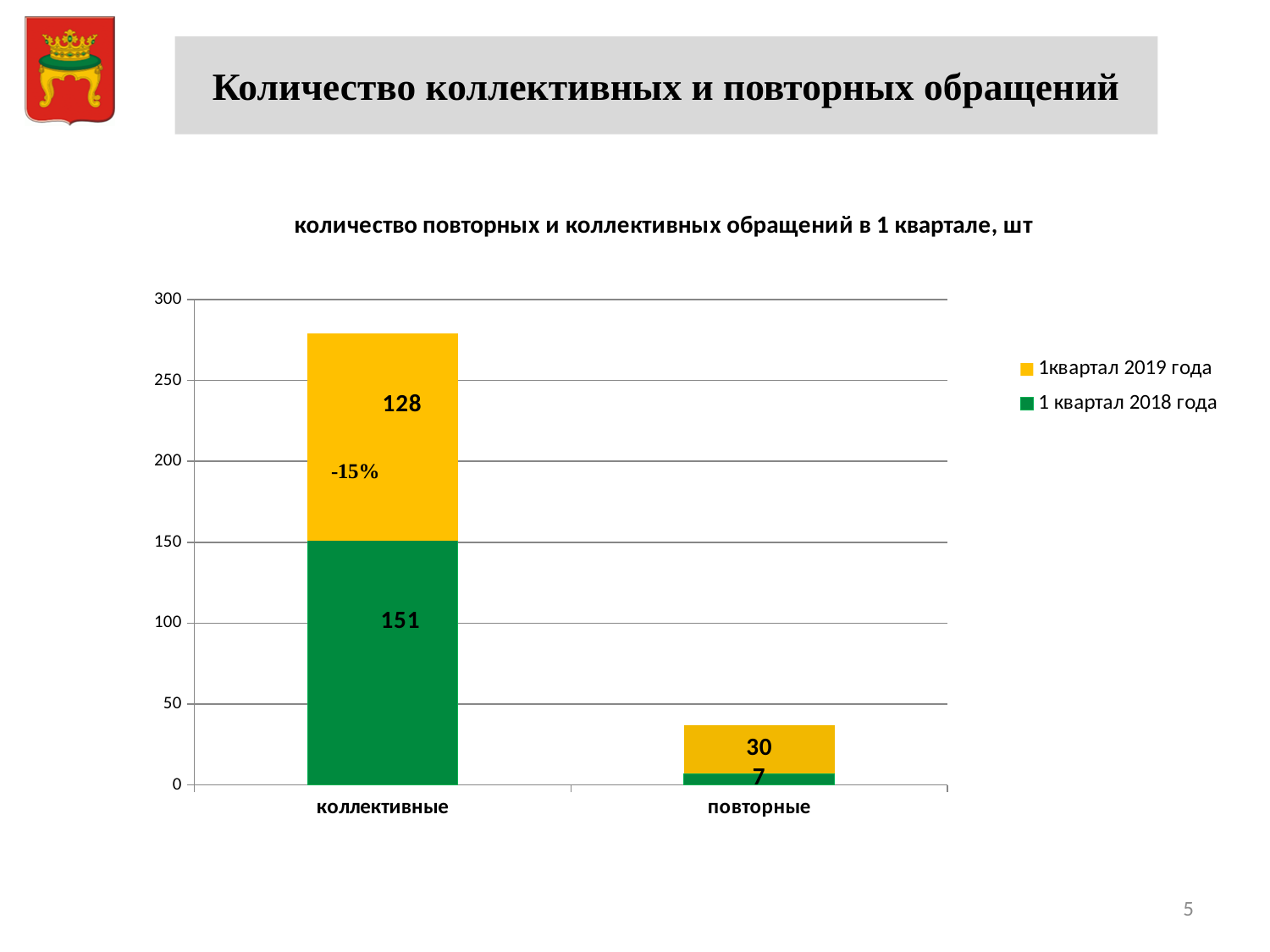
Which category has the highest total stacked value? коллективные What is the value for 1 квартал 2018 года in the коллективные category? 151 What is the total of the stacked bar for коллективные? 279 What is the difference between the 1 квартал 2018 года and 1квартал 2019 года values for коллективные? 23 What is the value for 1квартал 2019 года in the коллективные category? 128 What kind of chart is shown on the slide? Stacked bar chart Which is larger for повторные: the 1квартал 2019 года value or the 1 квартал 2018 года value? 1квартал 2019 года How many categories are shown on the x axis? 2 How many series does the legend list? 2 What is the value for 1 квартал 2018 года in the повторные category? 7 What is the value for 1квартал 2019 года in the повторные category? 30 What is the total of the stacked bar for повторные? 37